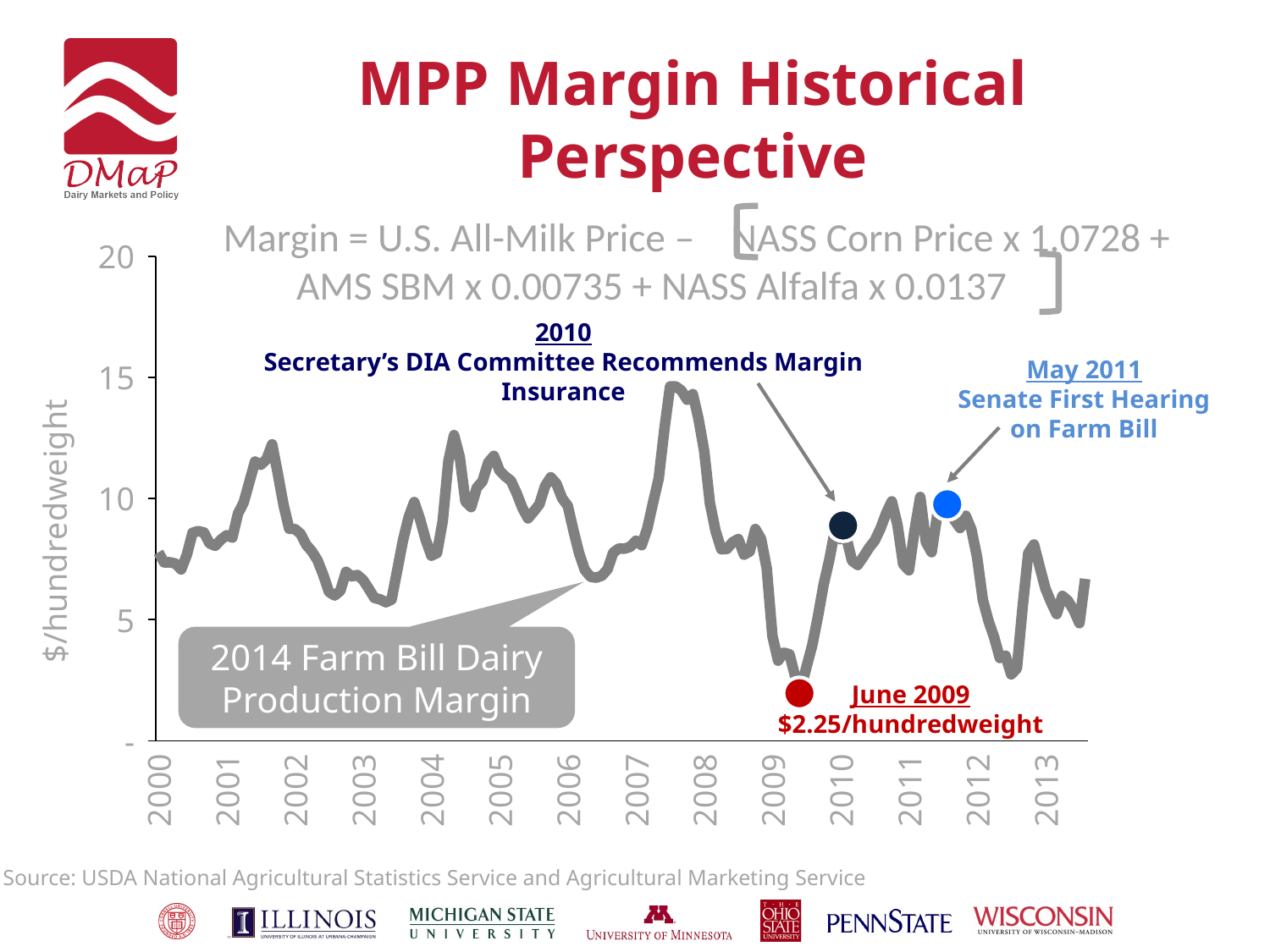
Is the margin in mid-2009 greater or less than 5? less Is the margin at the start of 2000 greater or less than 10? less What kind of chart is shown on the slide? line chart How many year labels are shown on the x axis? 14 What was the margin in June 2009, as labeled on the chart? $2.25/hundredweight Is the margin at the start of 2000 greater or less than 5? greater Does the margin rise or fall from the start of 2008 to mid-2009? fall Which is higher: the peak margin around 2004 or the peak margin around the start of 2008? the peak around the start of 2008 In which year does the margin reach its lowest point on the chart? 2009 What is the title of the slide containing the chart? MPP Margin Historical Perspective What is the label on the y axis? $/hundredweight